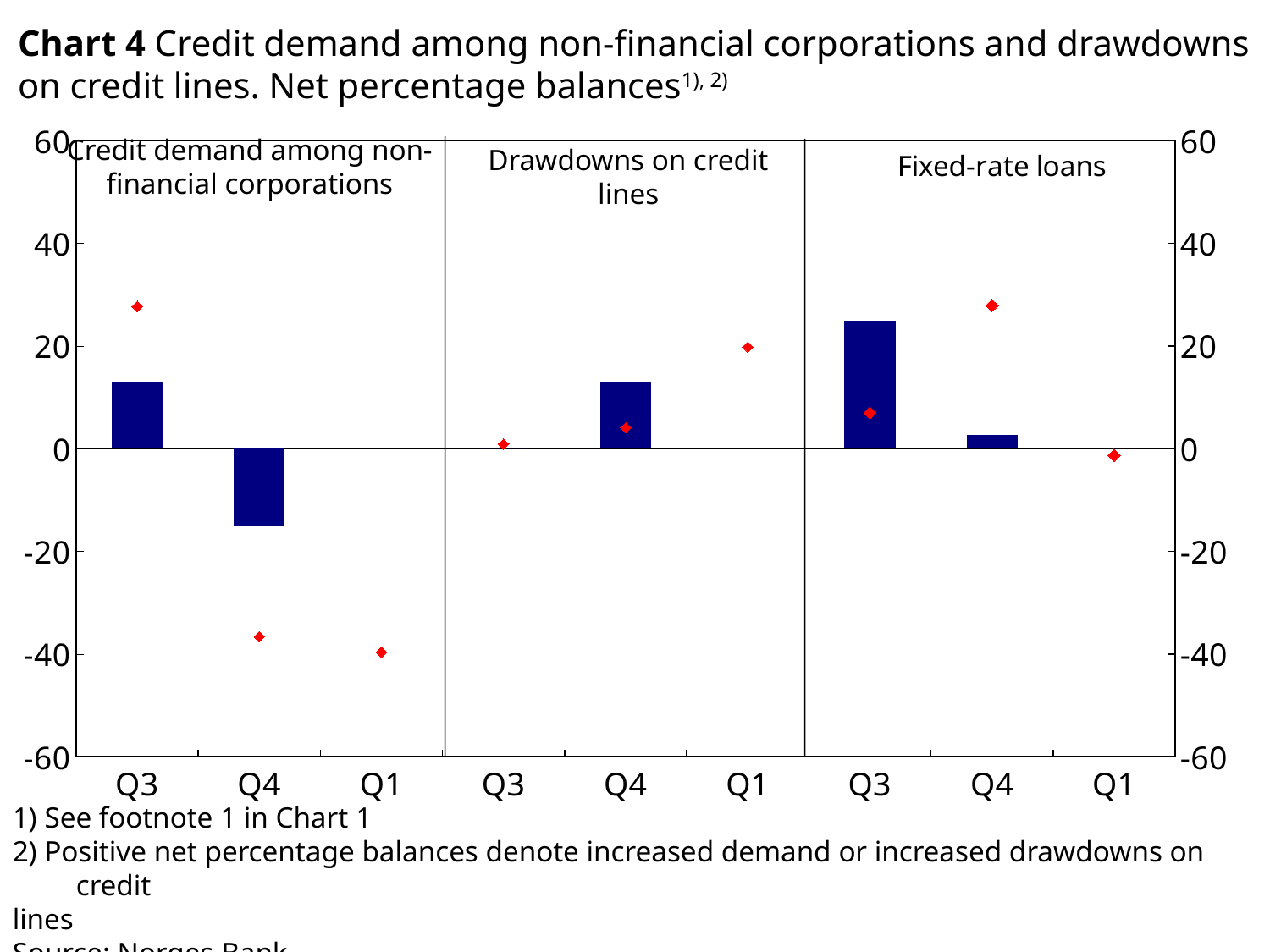
How many quarters are shown on the x axis of each panel? 3 In the 'Fixed-rate loans' panel, is the Q3 bar greater or less than 20? greater What colour are the bars in the chart? dark blue How many panels does the chart have? 3 In the 'Drawdowns on credit lines' panel, do the red diamonds rise or fall from Q3 to Q1? rise In the 'Credit demand among non-financial corporations' panel, is the Q1 red diamond greater or less than -20? less Which bar in the chart has the lowest value? Q4 in the Credit demand among non-financial corporations panel Which panel contains the tallest bar in the chart? Fixed-rate loans In the 'Credit demand among non-financial corporations' panel, is the Q3 bar greater or less than 20? less What kind of chart is shown on the slide? combination bar and line chart (bars with red diamond markers) In the 'Fixed-rate loans' panel, which bar is taller, Q3 or Q4? Q3